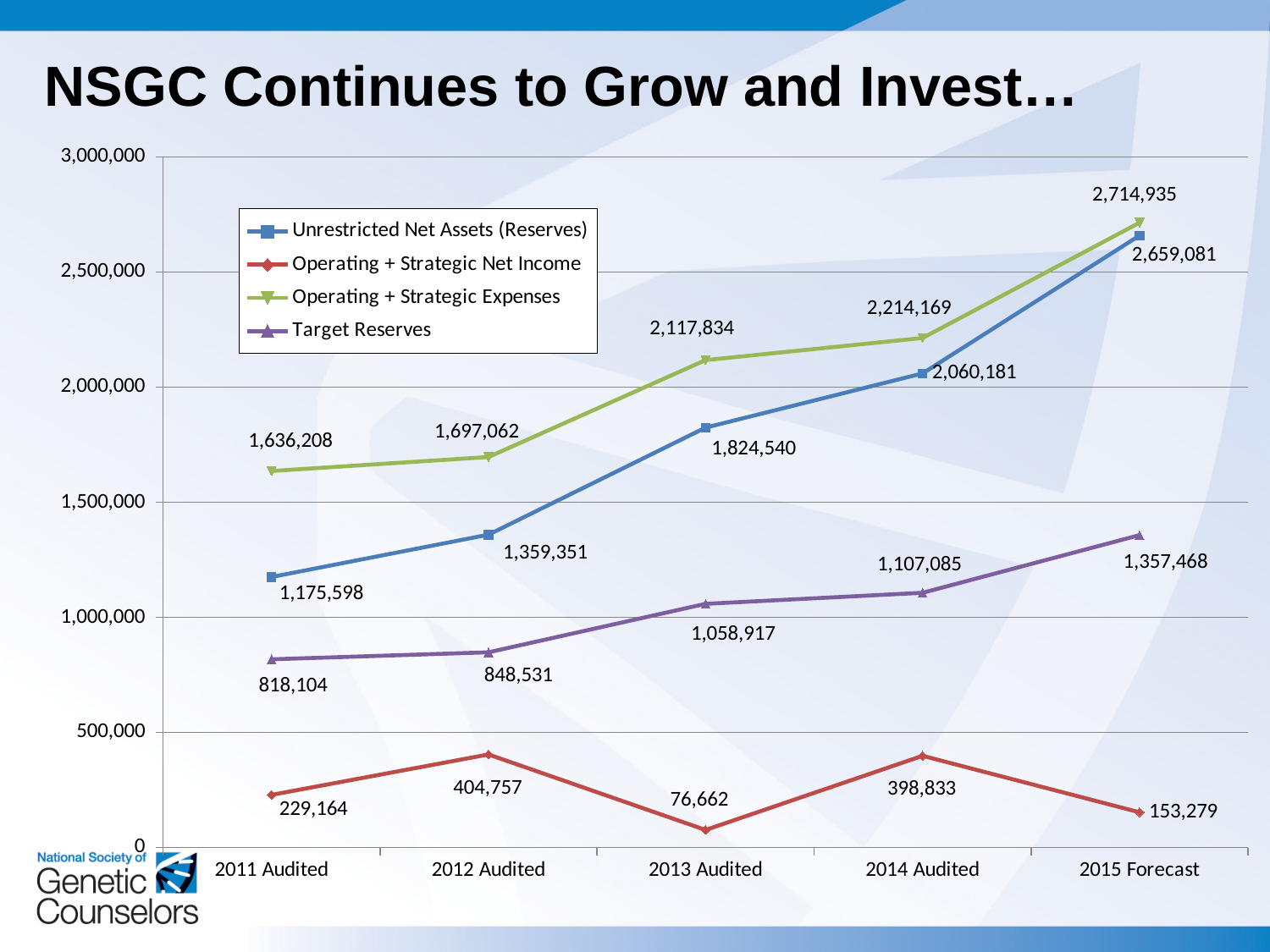
How many years are shown on the x axis? 5 In which year is Operating + Strategic Net Income highest? 2012 Audited Which is larger for 2014 Audited: Unrestricted Net Assets (Reserves) or Target Reserves? Unrestricted Net Assets (Reserves) Do the Operating + Strategic Expenses values rise or fall from 2011 Audited to 2015 Forecast? Rise In which year is Operating + Strategic Net Income lowest? 2013 Audited What kind of chart is shown on the slide? Line chart How many series does the legend list? 4 What is the difference between Operating + Strategic Expenses and Unrestricted Net Assets (Reserves) for 2015 Forecast? 55,854 What is the value of Operating + Strategic Net Income for 2014 Audited? 398,833 What is the value of Operating + Strategic Expenses for 2015 Forecast? 2,714,935 What is the value of Target Reserves for 2011 Audited? 818,104 What is the value of Unrestricted Net Assets (Reserves) for 2013 Audited? 1,824,540